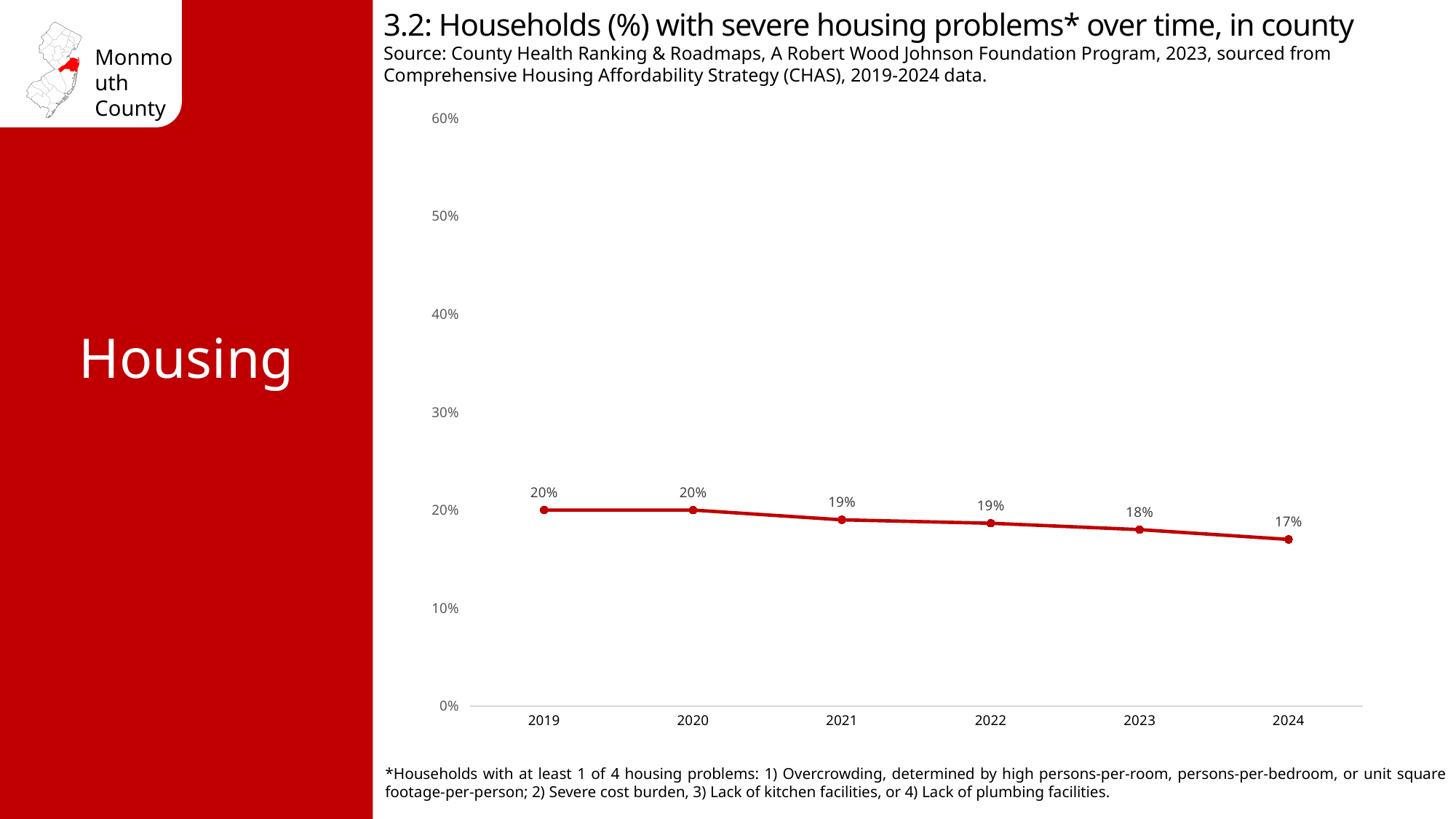
What percentage of households had severe housing problems in 2024? 17% How many years are plotted on the chart? 6 What is the difference between the 2019 value and the 2024 value? 3% What is the value shown for 2023? 18% What percentage of households had severe housing problems in 2019? 20% What is the value shown for 2021? 19% Do the values rise or fall from 2019 to 2024? fall What kind of chart is shown on the slide? line chart What is the title of the chart? 3.2: Households (%) with severe housing problems* over time, in county Which year has the lowest percentage of households with severe housing problems? 2024 Which is larger, the value for 2020 or the value for 2023? 2020 Is the value for 2022 greater or less than 30%? less